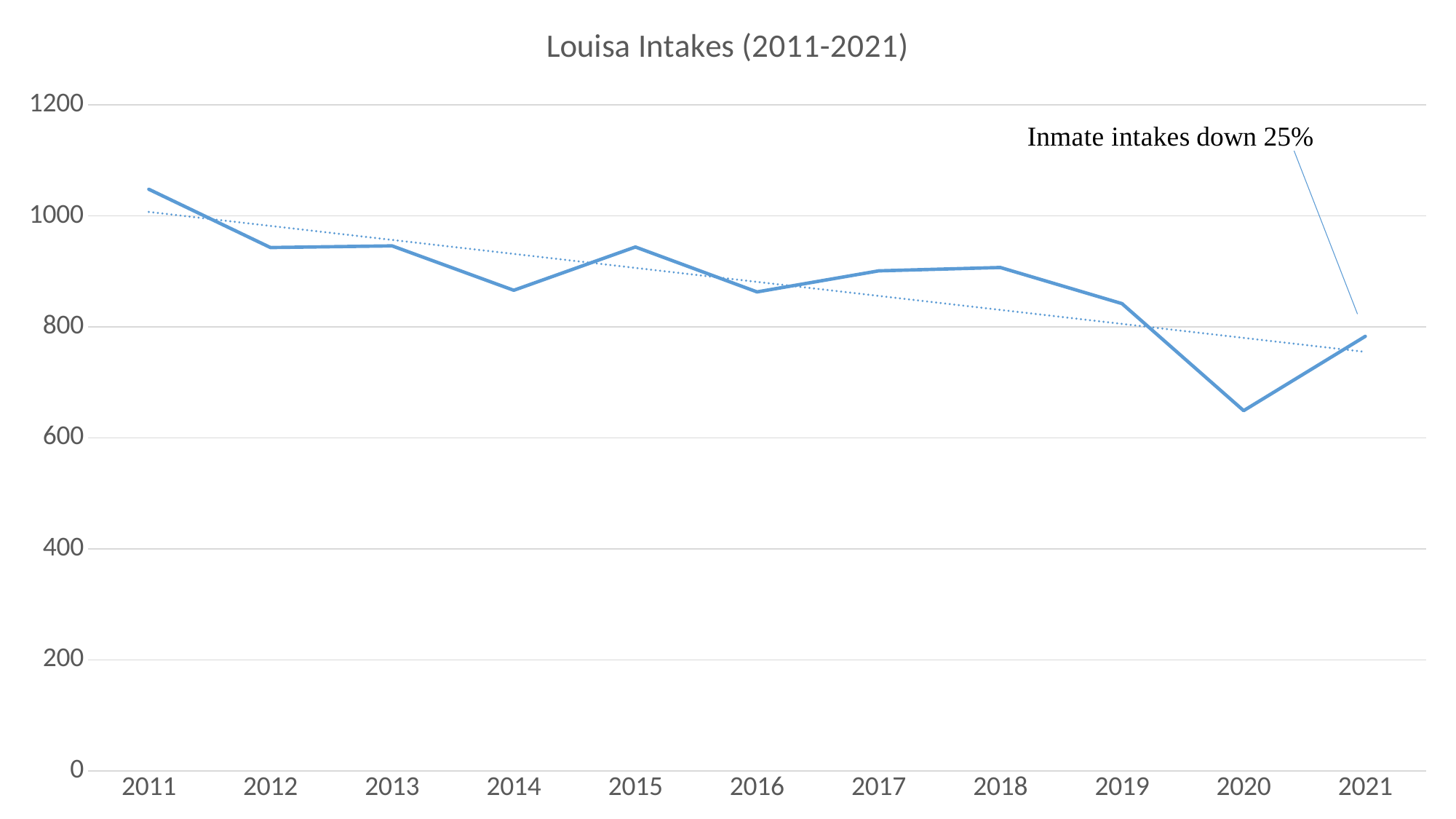
Which year has the highest number of intakes? 2011 Is the value for 2011 greater or less than 1000? greater How many years are plotted along the x axis? 11 What does the annotation text on the chart say? Inmate intakes down 25% Is the value for 2020 greater or less than 800? less Is the value for 2012 greater or less than 1000? less Which year has the larger value, 2014 or 2020? 2014 What kind of chart is shown on the slide? line chart Do intakes generally rise or fall from 2011 to 2021? fall Which year has the lowest number of intakes? 2020 What is the title of the chart? Louisa Intakes (2011-2021)